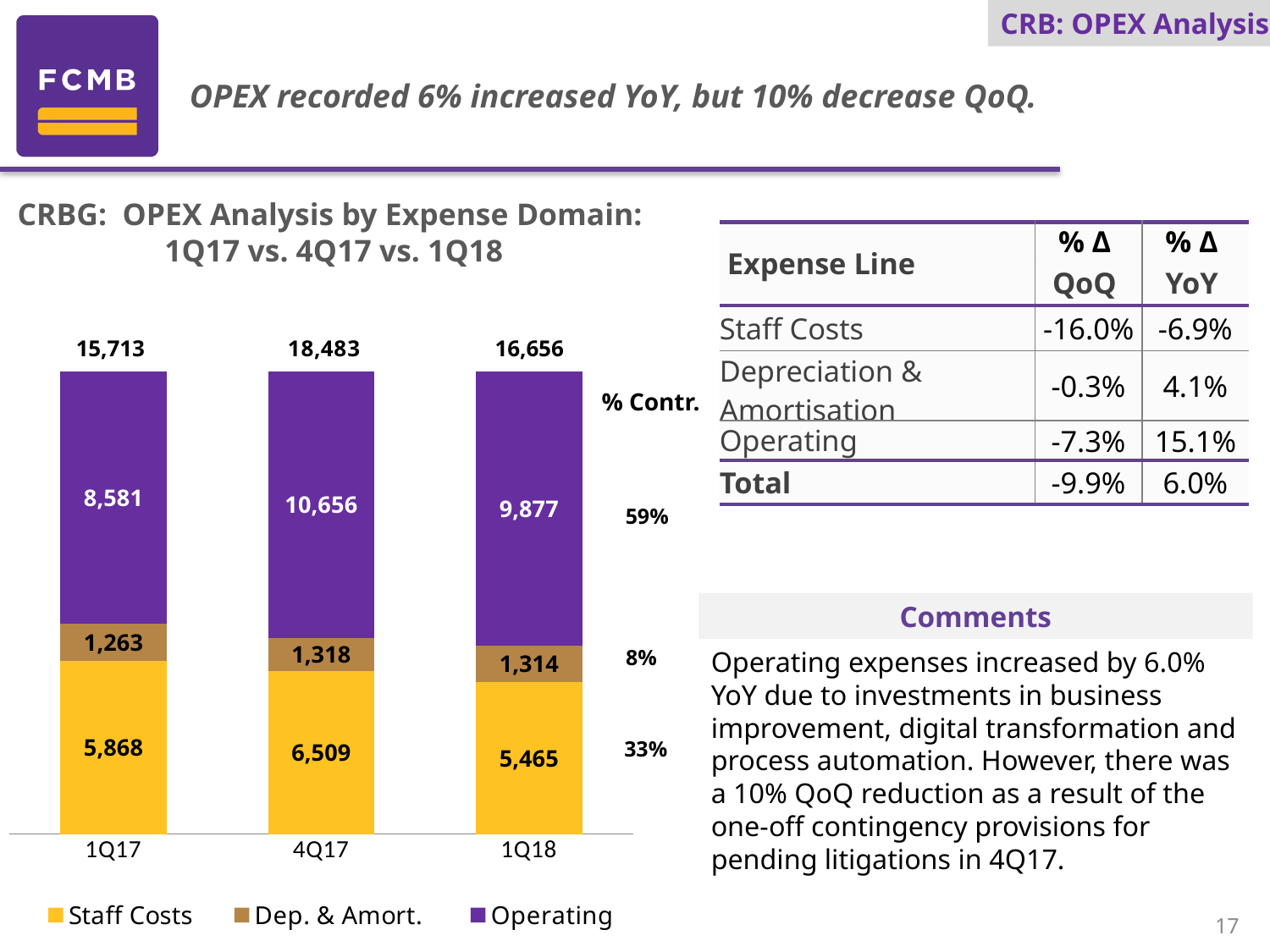
What is the Staff Costs value for 1Q17? 5,868 What is the difference between the Operating values for 4Q17 and 1Q18? 779 Which is larger, Staff Costs in 1Q17 or Staff Costs in 1Q18? 1Q17 How many quarters are shown on the x axis? 3 What is the Operating value for 4Q17? 10,656 What is the % Contr. shown for Operating in 1Q18? 59% What is the total OPEX shown for 4Q17? 18,483 Which quarter has the lowest total OPEX? 1Q17 What kind of chart is shown? Stacked bar chart How many series does the legend list? 3 What is the Dep. & Amort. value for 1Q18? 1,314 Which quarter has the highest total OPEX? 4Q17